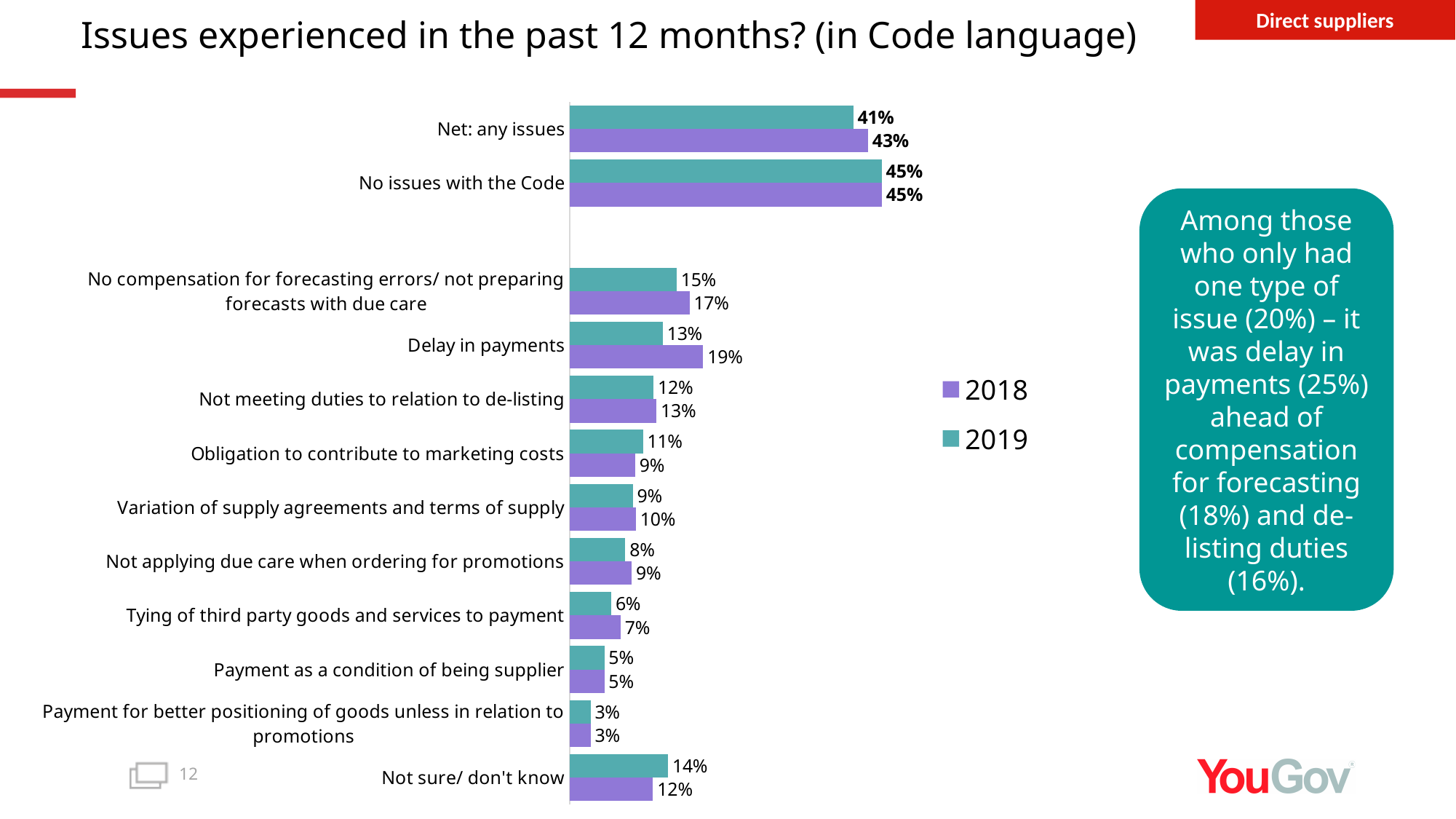
What is the 2019 value for Delay in payments? 13% Which category has the highest 2018 value? No issues with the Code What is the 2019 value for Net: any issues? 41% What is the difference between the 2018 and 2019 values for Delay in payments? 6% What is the 2018 value for Not sure/ don't know? 12% Which category has the lowest 2019 value? Payment for better positioning of goods unless in relation to promotions Which is larger for Obligation to contribute to marketing costs, the 2018 value or the 2019 value? 2019 What is the 2018 value for Delay in payments? 19% How many categories are shown on the chart? 12 How many series does the legend list? 2 Which colour represents the 2019 series in the legend? Teal What kind of chart is shown on the slide? Bar chart